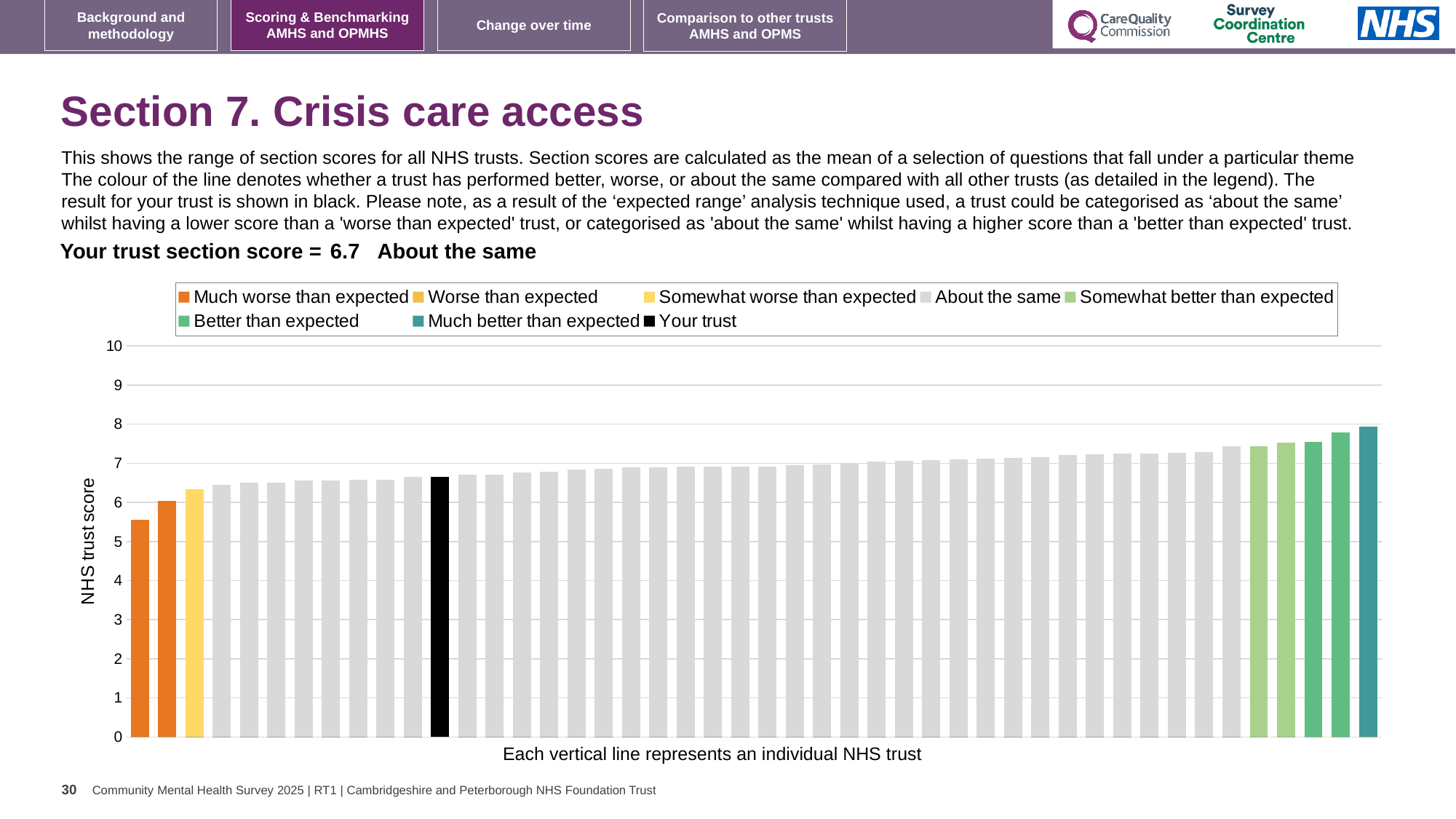
Which legend category does the lowest bar on the chart belong to? Much worse than expected Is the value for the highest-scoring trust greater or less than 7? greater Is the value for your trust (black bar) greater or less than 7? less How many entries does the chart legend list? 8 Is the value for the lowest-scoring trust greater or less than 6? less Do the bar values rise or fall from left to right along the x axis? rise Which legend category does the highest bar on the chart belong to? Much better than expected What is the section score for your trust shown on the slide? 6.7 Which category is your trust placed in for this section? About the same What kind of chart is shown on the slide? bar chart What is the label on the vertical axis of the chart? NHS trust score How many trusts are shown as 'Much worse than expected' (orange bars)? 2